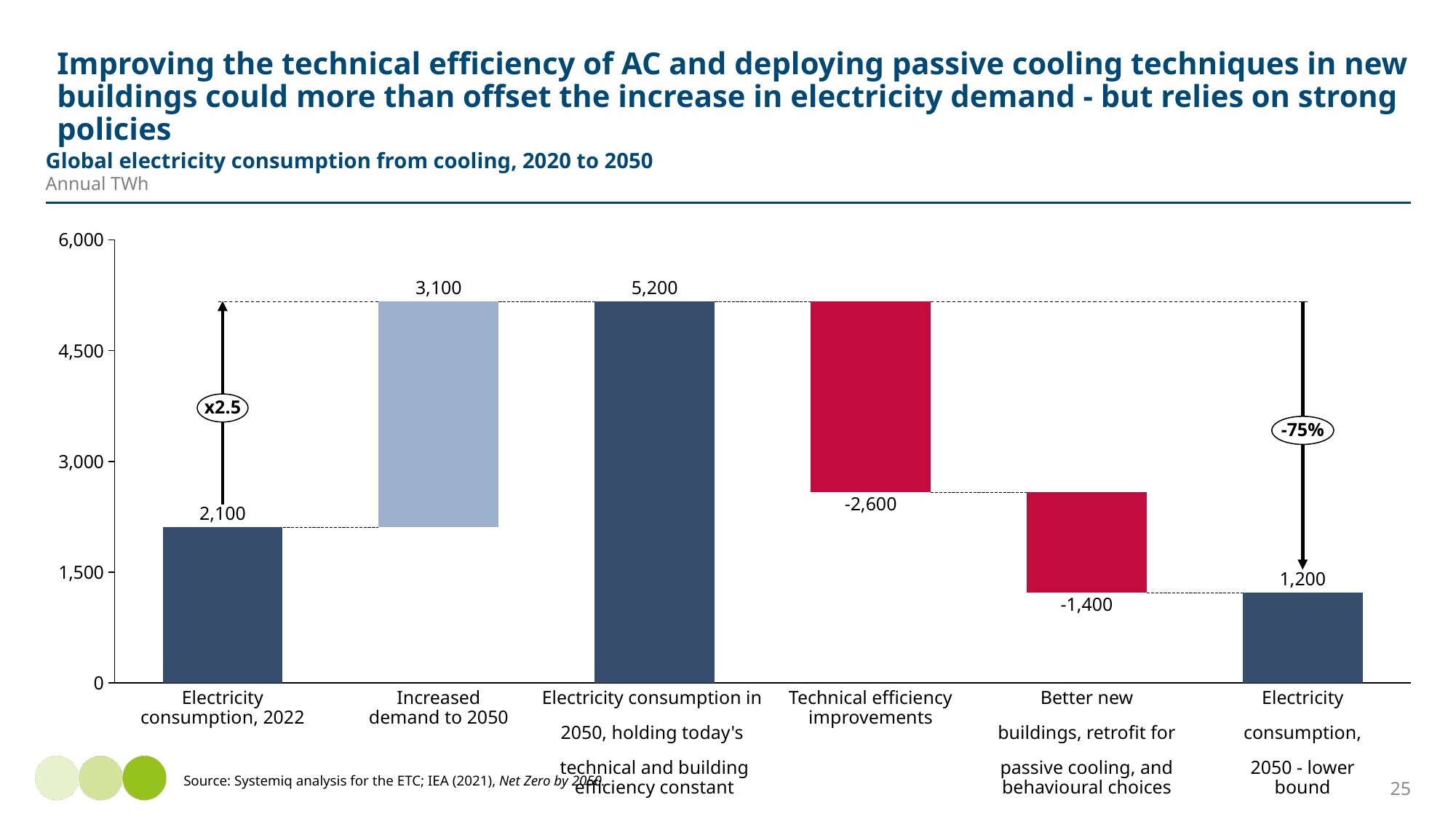
What is the value for Better new buildings, retrofit for passive cooling, and behavioural choices? -1,400 Which category has the highest value? Electricity consumption in 2050, holding today's technical and building efficiency constant Which is larger: the value for Electricity consumption, 2022 or the value for Electricity consumption, 2050 - lower bound? Electricity consumption, 2022 What is the value for Electricity consumption in 2050, holding today's technical and building efficiency constant? 5,200 What unit is the chart measured in, according to the subtitle? Annual TWh What is the difference between Electricity consumption in 2050 holding efficiency constant (5,200) and Electricity consumption, 2022 (2,100)? 3,100 What is the value for Increased demand to 2050? 3,100 What is the value for Electricity consumption, 2050 - lower bound? 1,200 What is the value for Electricity consumption, 2022? 2,100 What kind of chart is shown on the slide? Waterfall bar chart What is the value for Technical efficiency improvements? -2,600 How many categories are shown on the x axis? 6